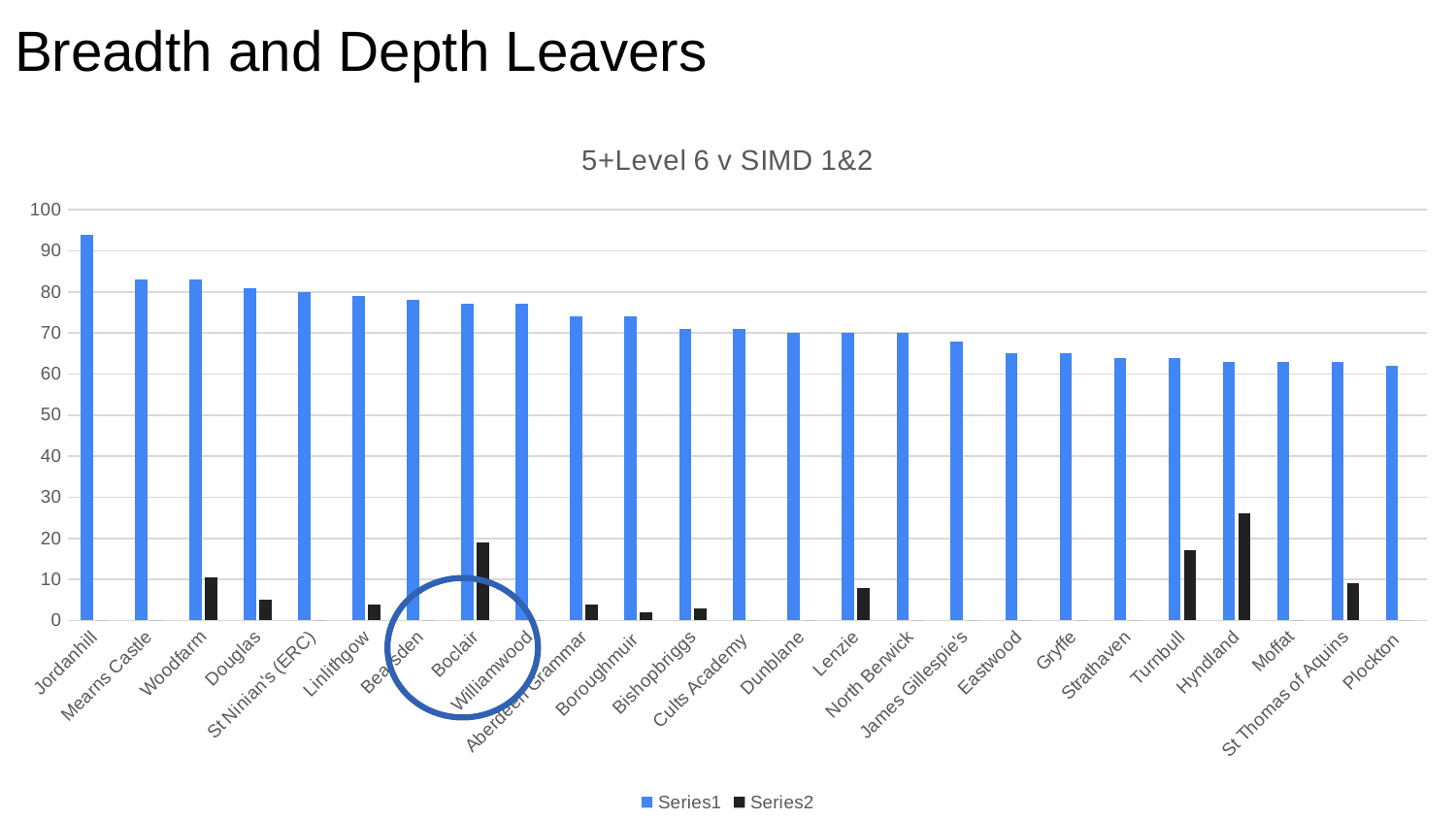
Which school has the highest Series1 value? Jordanhill Which school has the highest Series2 value? Hyndland How many series does the legend list? 2 What kind of chart is shown on the slide? bar chart Do the Series1 values generally rise or fall from left to right along the x axis? fall Is the Series2 value for Boclair greater or less than 10? greater Is the Series1 value for Jordanhill greater or less than 90? greater Which has the larger Series2 value, Turnbull or Woodfarm? Turnbull Is the Series1 value for Plockton greater or less than 70? less How many schools (categories) are shown on the x axis? 25 What is the title of the chart? 5+Level 6 v SIMD 1&2